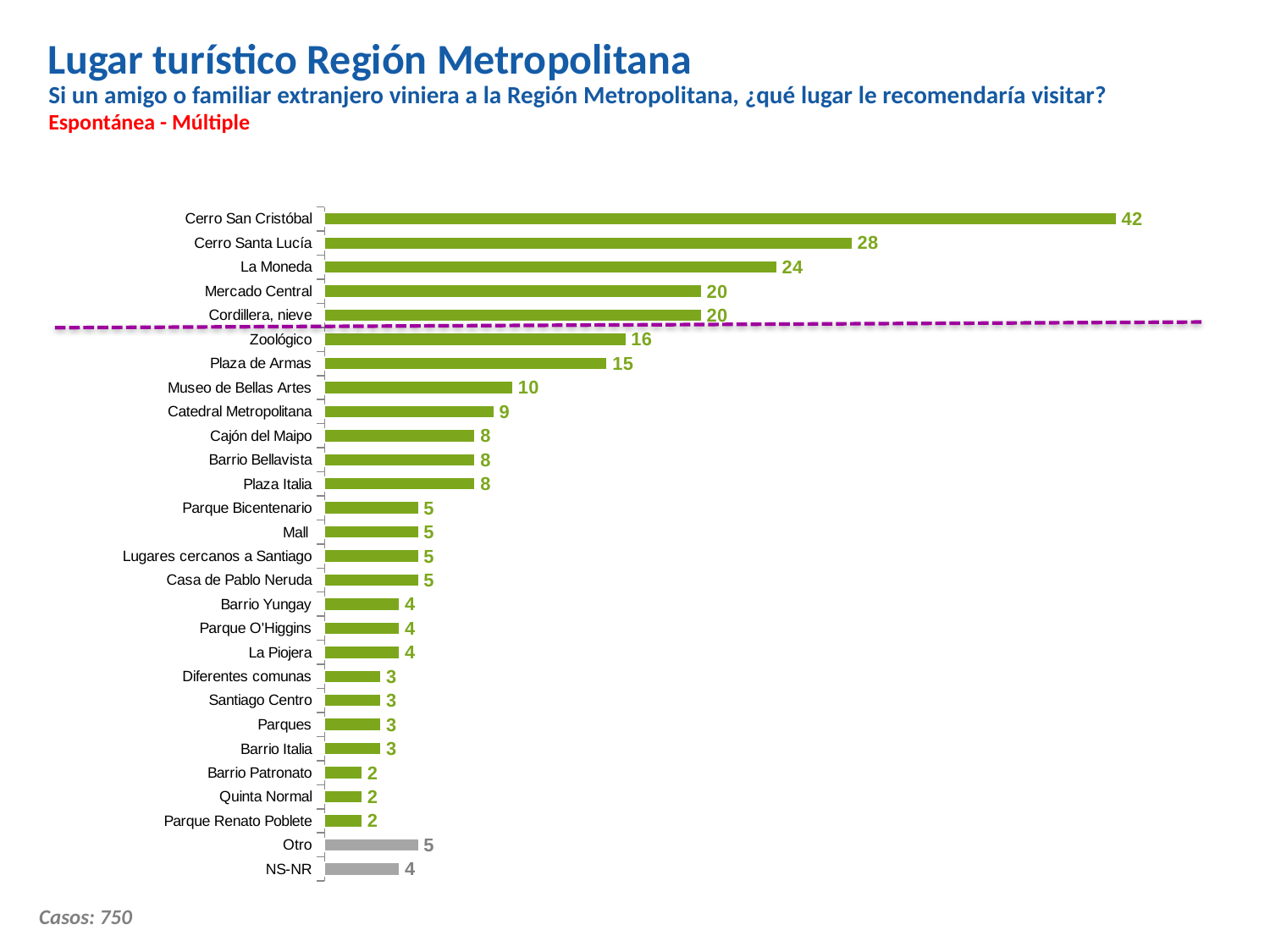
What is the value for Otro? 5 How many categories are shown in the chart? 28 What is the value for La Moneda? 24 What is the difference between the values for Cerro San Cristóbal and Cerro Santa Lucía? 14 What kind of chart is shown on the slide? Bar chart What is the value for Cerro San Cristóbal? 42 Which is larger, the value for Catedral Metropolitana or the value for Cajón del Maipo? Catedral Metropolitana What is the value for Museo de Bellas Artes? 10 What is the number of cases (Casos) stated on the slide? 750 Which is larger, the value for Mercado Central or the value for Zoológico? Mercado Central Which category has the highest value? Cerro San Cristóbal What is the difference between the values for Zoológico and Plaza de Armas? 1